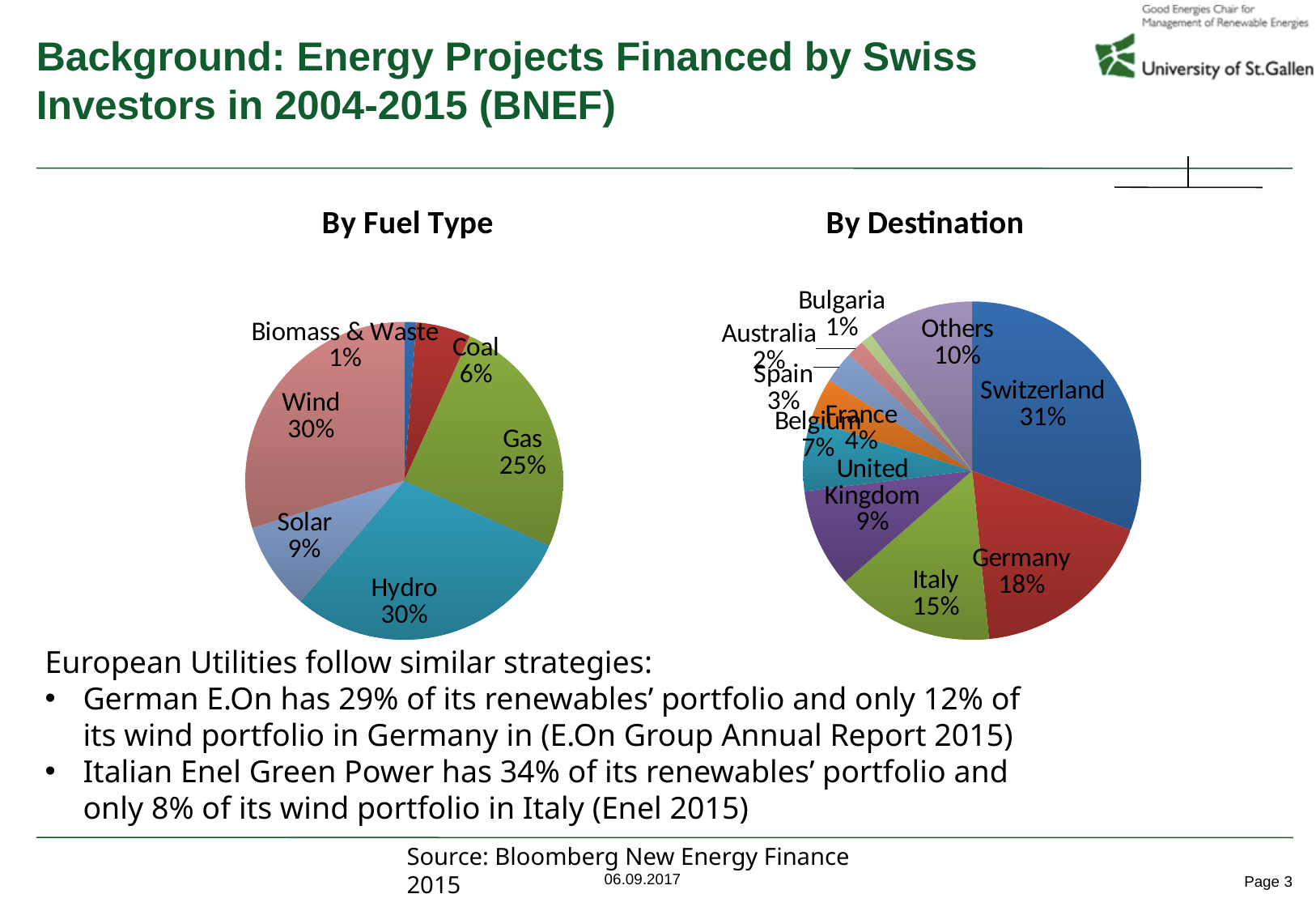
In the 'By Destination' chart, what is the difference between the shares of Switzerland and Germany? 13% In the 'By Destination' chart, which destination has the smallest share? Bulgaria In the 'By Destination' chart, what share does Switzerland have? 31% In the 'By Fuel Type' chart, what is the difference between the shares of Gas and Coal? 19% In the 'By Destination' chart, which is larger, the share for Germany or the share for Italy? Germany In the 'By Destination' chart, what share does the United Kingdom have? 9% In the 'By Fuel Type' chart, which fuel type has the smallest share? Biomass & Waste In the 'By Destination' chart, which destination has the largest share? Switzerland In the 'By Fuel Type' chart, what share does Gas have? 25% What type of chart is the 'By Destination' chart? Pie chart In the 'By Fuel Type' chart, how many fuel types are shown? 6 In the 'By Fuel Type' chart, what share does Solar have? 9%